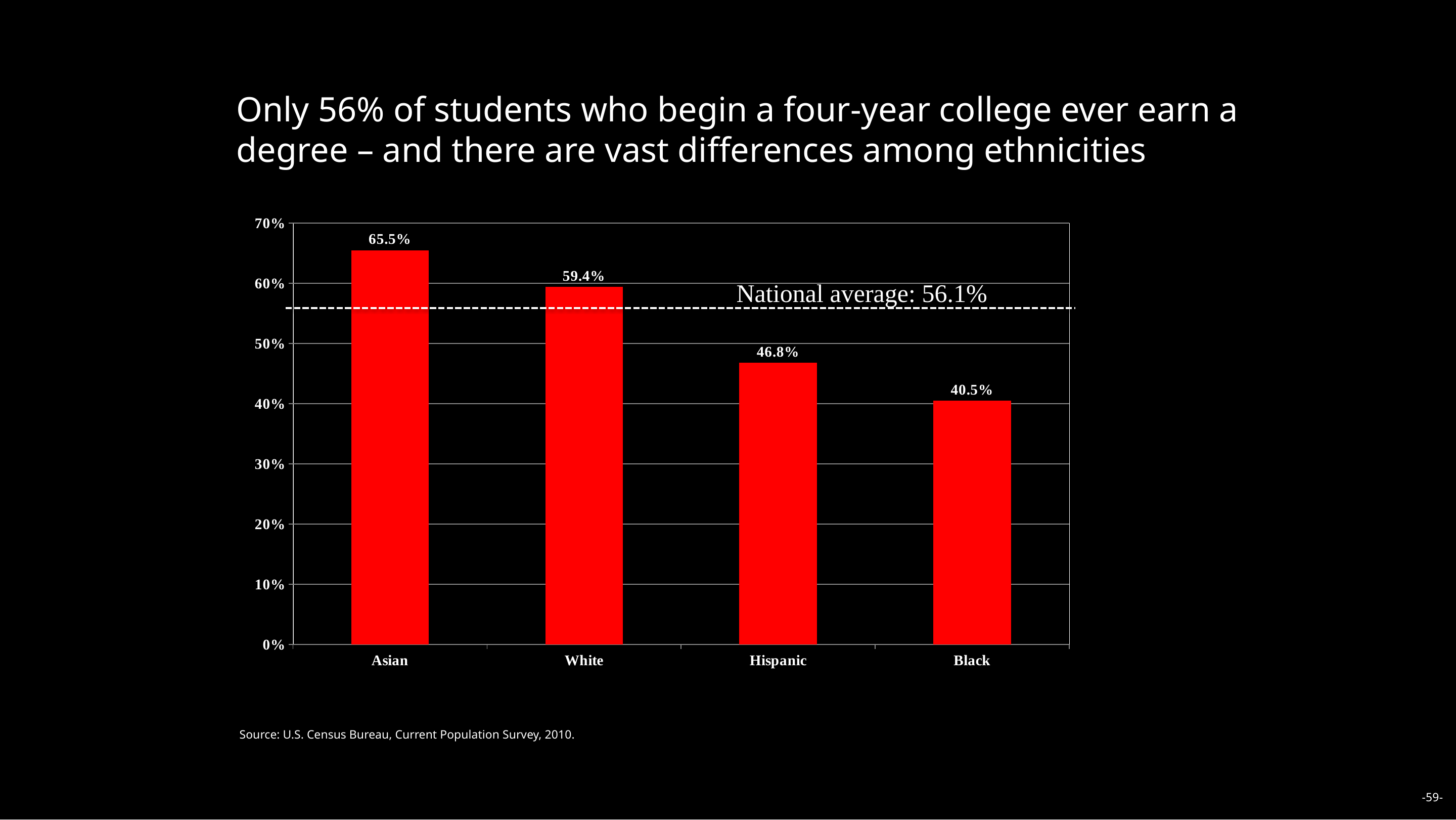
What is the difference between the values for White and Hispanic? 12.6% Is the value for Hispanic greater or less than 50%? less What national average does the dashed line on the chart indicate? 56.1% What kind of chart is shown on the slide? bar chart Which is larger, the value for White or the value for Hispanic? White What is the value for Asian? 65.5% Which category has the lowest value? Black What is the value for Hispanic? 46.8% What is the value for Black? 40.5% What is the difference between the values for Asian and Black? 25.0% Which category has the highest value? Asian How many categories are shown on the x axis? 4